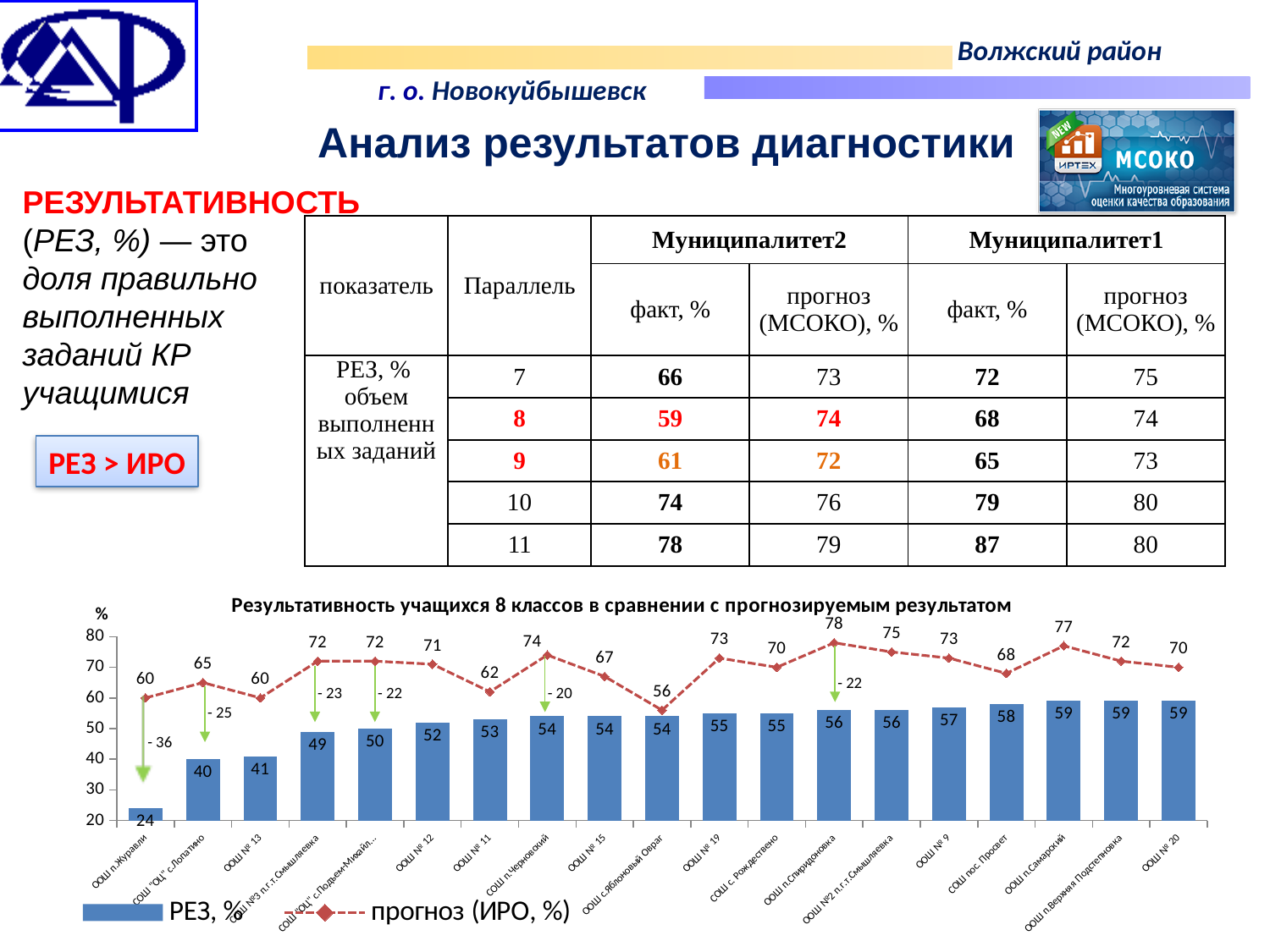
Which school has the lowest прогноз (ИРО, %) value? ООШ с.Яблоновый Овраг What is the difference between the прогноз (ИРО, %) and РЕЗ, % values for ООШ п.Журавли? 36 How many series does the chart legend list? 2 Is the РЕЗ, % value for ООШ № 20 greater or less than 50? greater Which school has the lowest РЕЗ, % value? ООШ п.Журавли What is the РЕЗ, % value for ООШ п.Журавли? 24 What is the прогноз (ИРО, %) value for ООШ п.Спиридоновка? 78 Do the РЕЗ, % bar values rise or fall from left to right along the x axis? rise What is the РЕЗ, % value for ООШ № 9? 57 How many schools are shown on the x axis of the chart? 19 Which has the larger РЕЗ, % value: ООШ № 13 or СОШ "ОЦ" с.Лопатино? ООШ № 13 Which school has the highest прогноз (ИРО, %) value? ООШ п.Спиридоновка